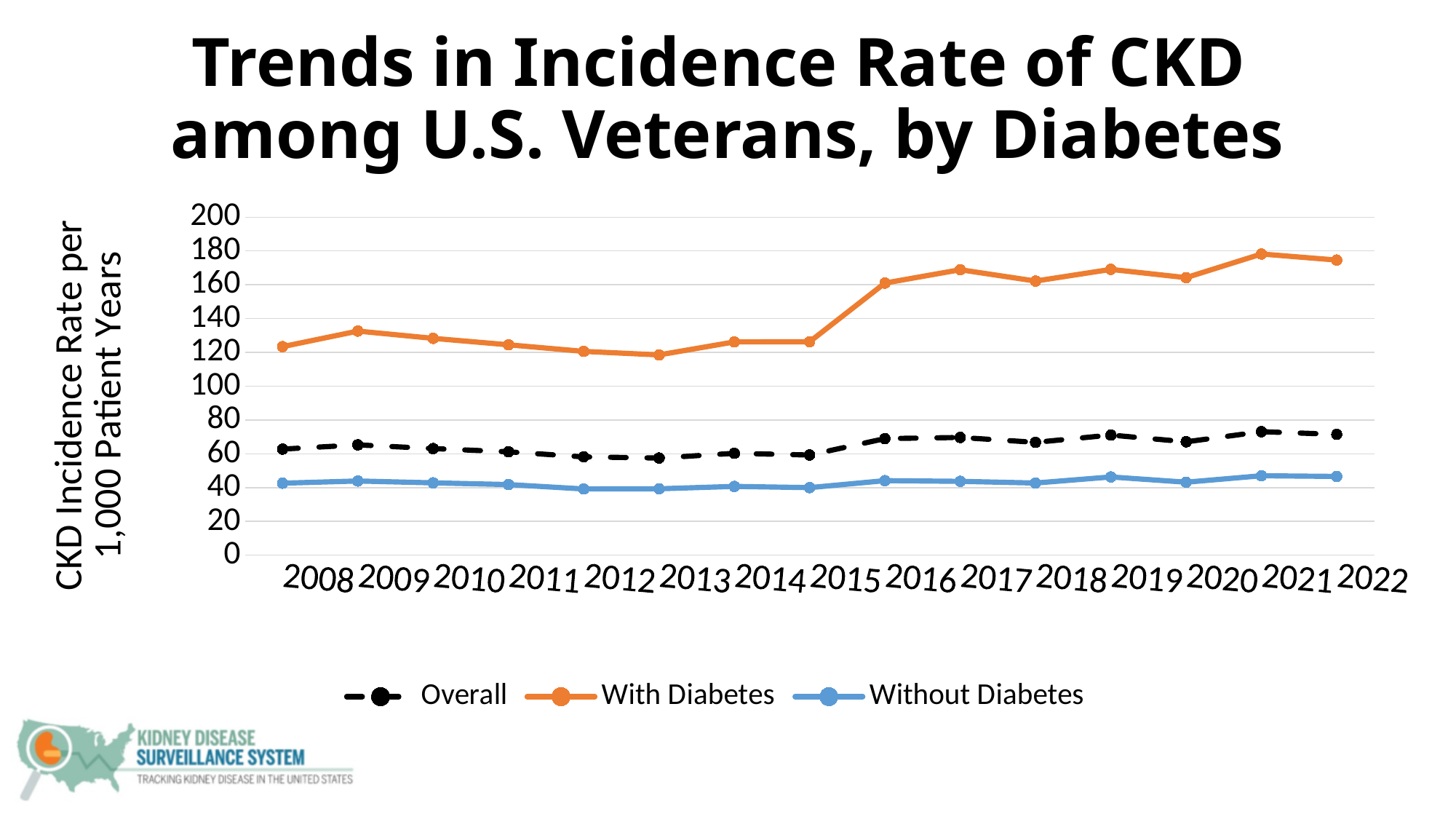
What is the label on the y axis? CKD Incidence Rate per 1,000 Patient Years Which series has the lowest CKD incidence rate across all years? Without Diabetes For the With Diabetes series, which is larger: the value in 2008 or the value in 2016? 2016 What kind of chart is shown on the slide? line chart Is the value for Without Diabetes in 2012 greater or less than 60? less Is the value for With Diabetes in 2021 greater or less than 160? greater How many years are plotted along the x axis? 15 Is the value for Overall in 2021 greater or less than 60? greater Does the With Diabetes series rise or fall between 2015 and 2016? rise How many series does the legend list? 3 Which series has the highest CKD incidence rate across all years? With Diabetes